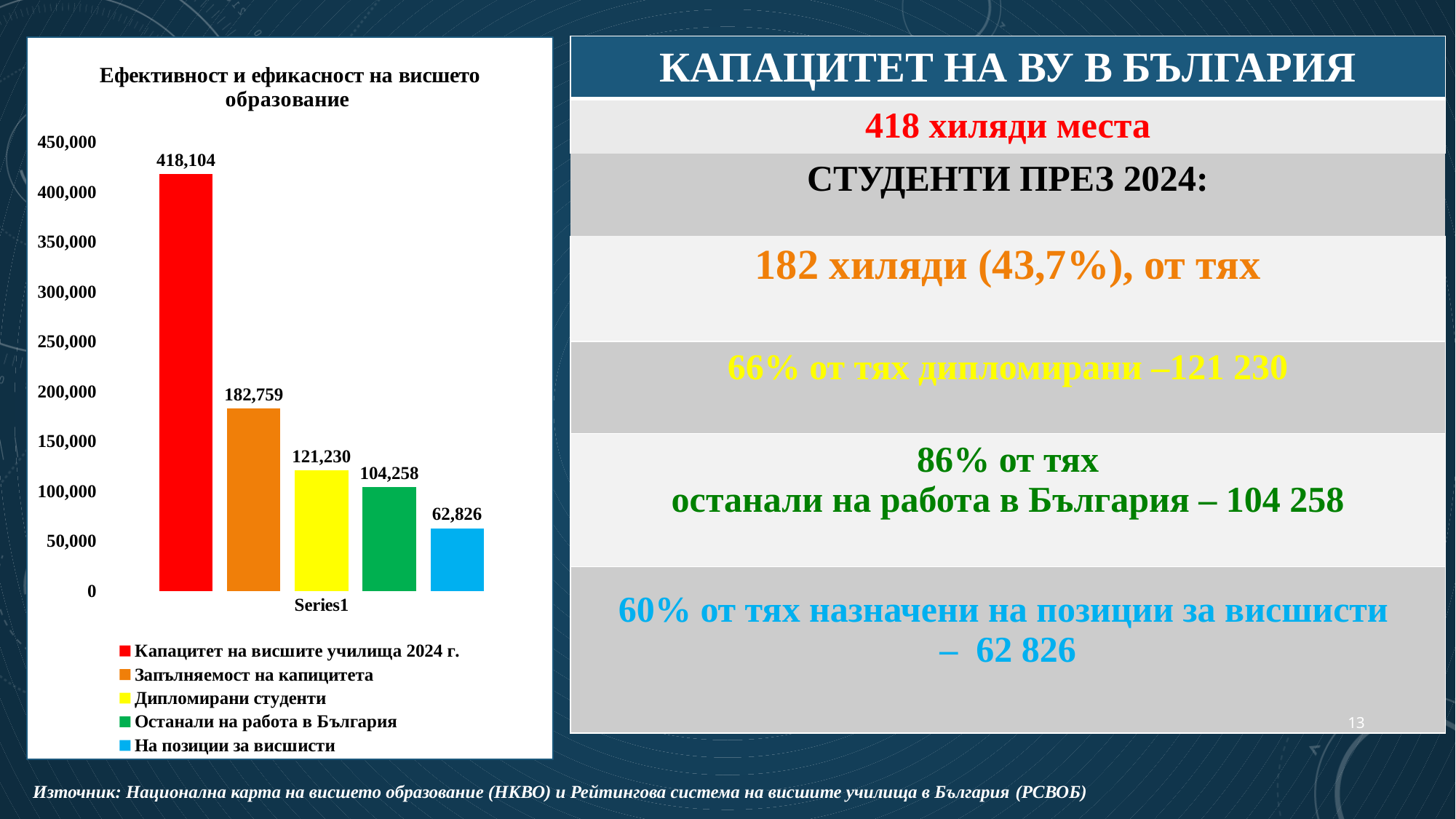
Which is larger, 'Дипломирани студенти' or 'Останали на работа в България'? Дипломирани студенти What is the value for 'Запълняемост на капицитета'? 182,759 What is the title of the chart? Ефективност и ефикасност на висшето образование What is the value for 'Дипломирани студенти'? 121,230 Which series has the lowest value? На позиции за висшисти What is the value for 'Останали на работа в България'? 104,258 What is the difference between 'Капацитет на висшите училища 2024 г.' and 'Запълняемост на капицитета'? 235,345 Which series has the highest value? Капацитет на висшите училища 2024 г. What type of chart is shown on the slide? bar chart How many series does the chart legend list? 5 What is the value for 'Капацитет на висшите училища 2024 г.'? 418,104 What is the value for 'На позиции за висшисти'? 62,826